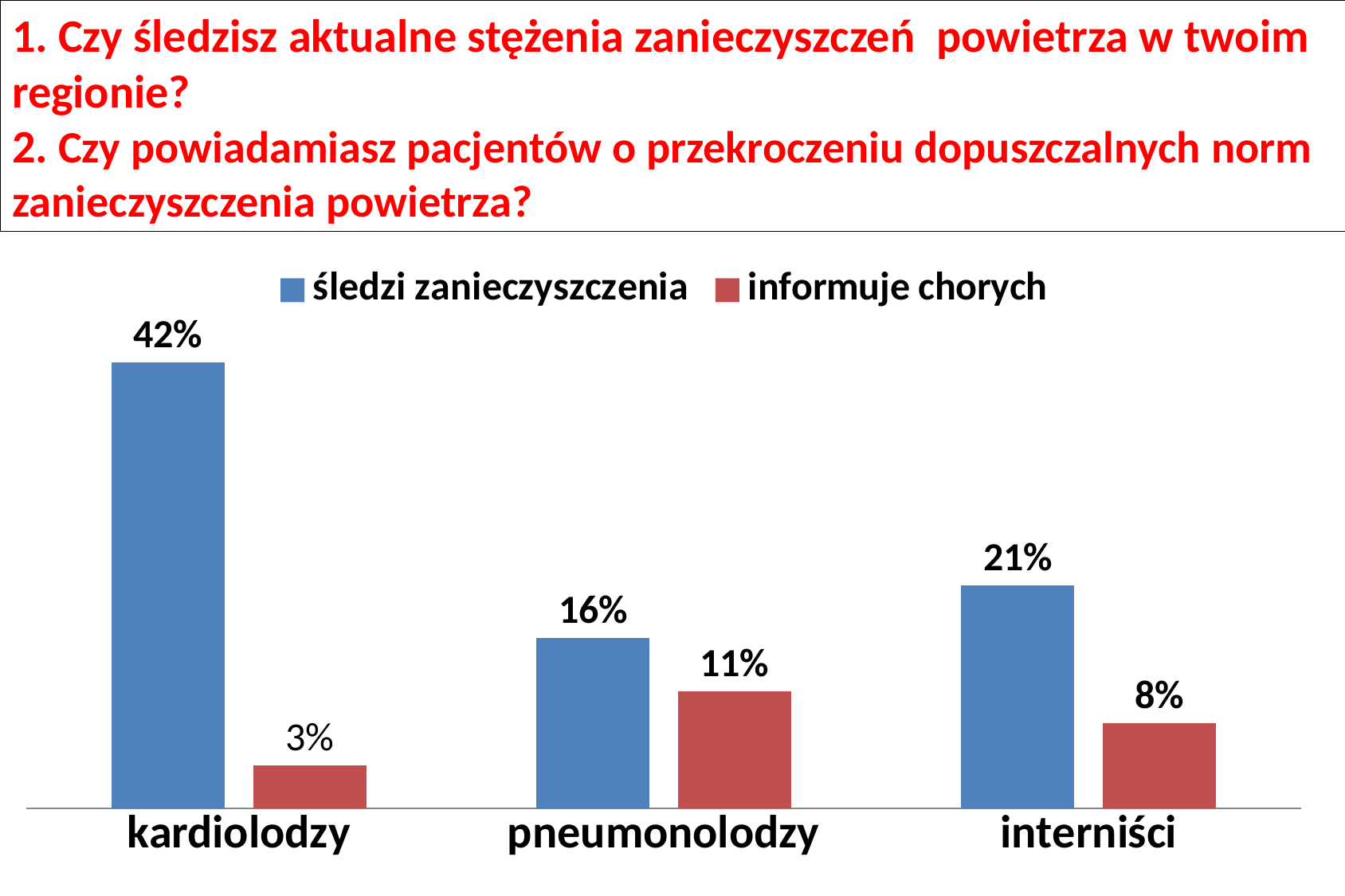
How many groups of doctors are shown on the x axis? 3 What percentage of kardiolodzy 'informuje chorych'? 3% How many series does the legend list? 2 Which is larger: 'informuje chorych' for pneumonolodzy or for interniści? pneumonolodzy What kind of chart is shown on the slide? bar chart What percentage of kardiolodzy 'śledzi zanieczyszczenia'? 42% What is the difference between 'śledzi zanieczyszczenia' and 'informuje chorych' for kardiolodzy? 39% Which group has the lowest value for 'informuje chorych'? kardiolodzy What percentage of interniści 'śledzi zanieczyszczenia'? 21% What percentage of pneumonolodzy 'informuje chorych'? 11% What is the difference between the 'śledzi zanieczyszczenia' values for interniści and pneumonolodzy? 5% Which group has the highest value for 'śledzi zanieczyszczenia'? kardiolodzy